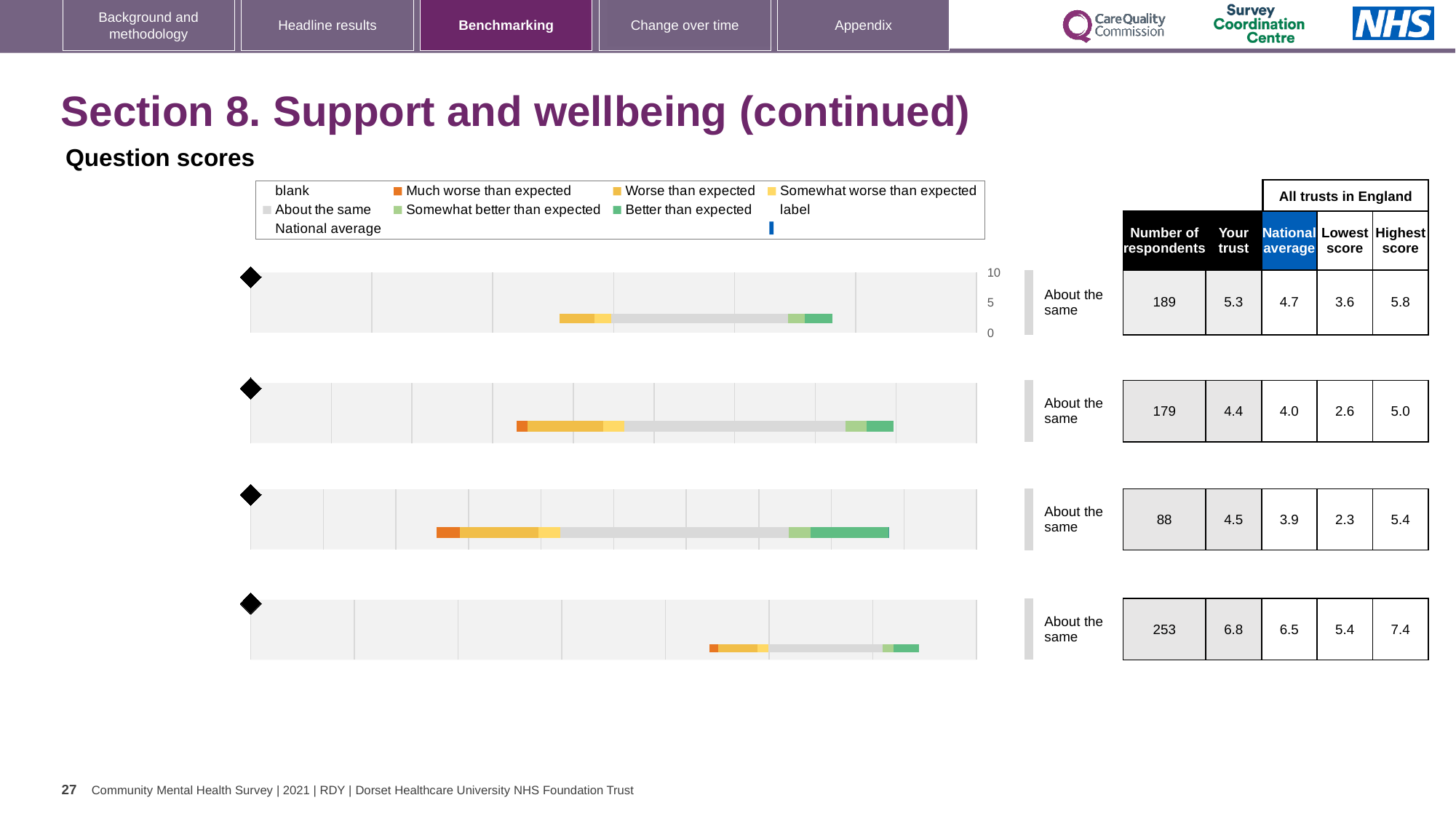
What benchmark category is shown next to each of the four charts? About the same For the first (top) chart, what is the 'Your trust' score shown in the table? 5.3 What kind of chart is used to show the question scores on this slide? bar chart For the fourth (bottom) chart, which is larger: the 'Your trust' score or the national average? Your trust How many bar charts are shown on the slide? 4 For the second chart from the top, what is the national average score? 4.0 For the third chart from the top, what is the difference between the highest score and the lowest score among all trusts in England? 3.1 For the first (top) chart, what is the difference between the 'Your trust' score and the national average? 0.6 For the third chart from the top, how many respondents are listed? 88 Which of the four charts has the lowest number of respondents? the third chart For the fourth (bottom) chart, what is the highest score among all trusts in England? 7.4 Which of the four charts has the highest 'Your trust' score? the fourth (bottom) chart